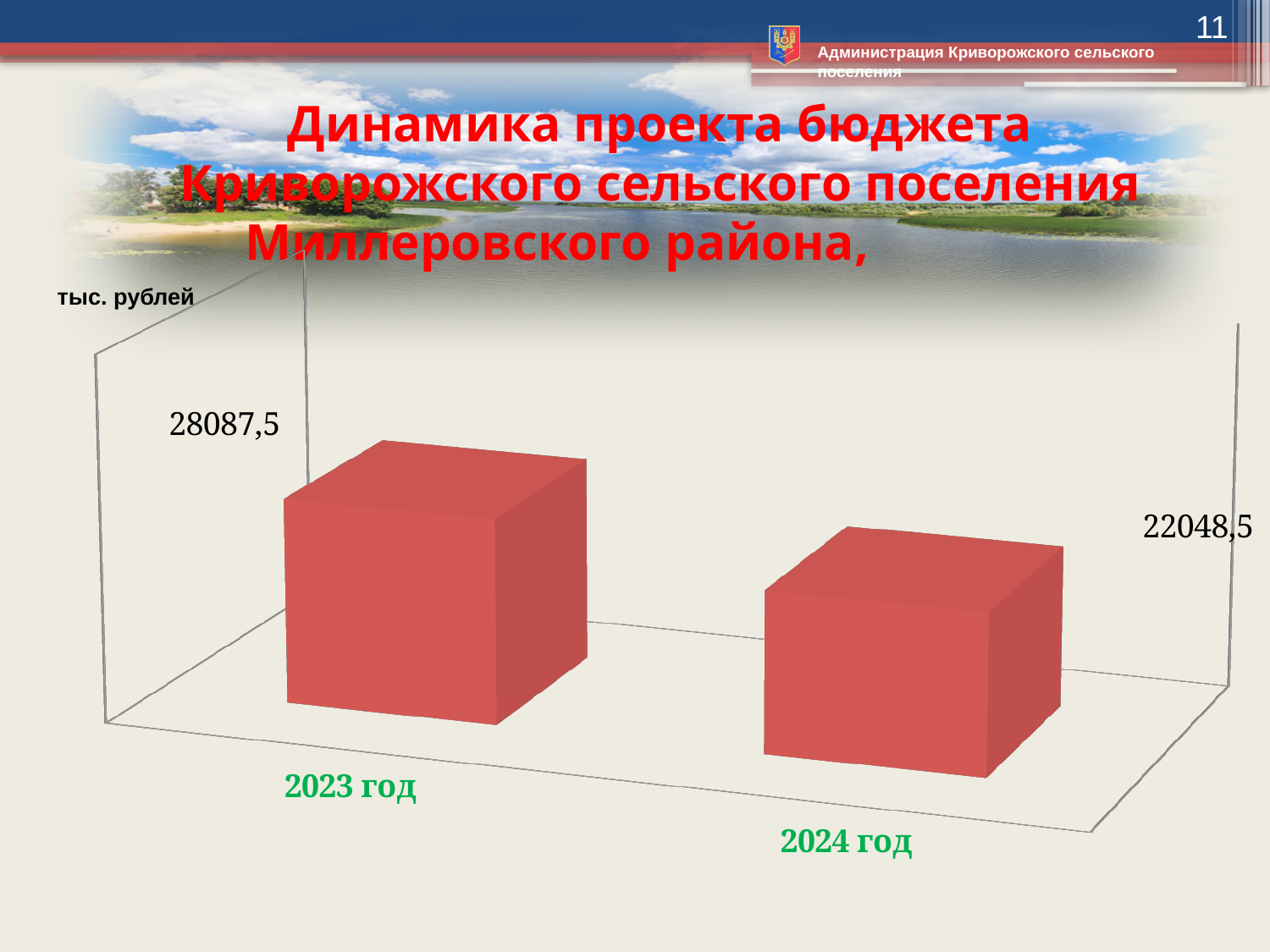
What kind of chart is shown on the slide? bar chart Which year has the lowest value? 2024 год Which is larger, the value for 2023 год or for 2024 год? 2023 год Which year has the highest value? 2023 год How many categories are shown in the chart? 2 What is the value for 2023 год? 28087,5 Do the values rise or fall from 2023 год to 2024 год? fall What colour are the bars in the chart? red What is the difference between the values for 2023 год and 2024 год? 6039 What is the value for 2024 год? 22048,5 In what units are the chart values given? тыс. рублей